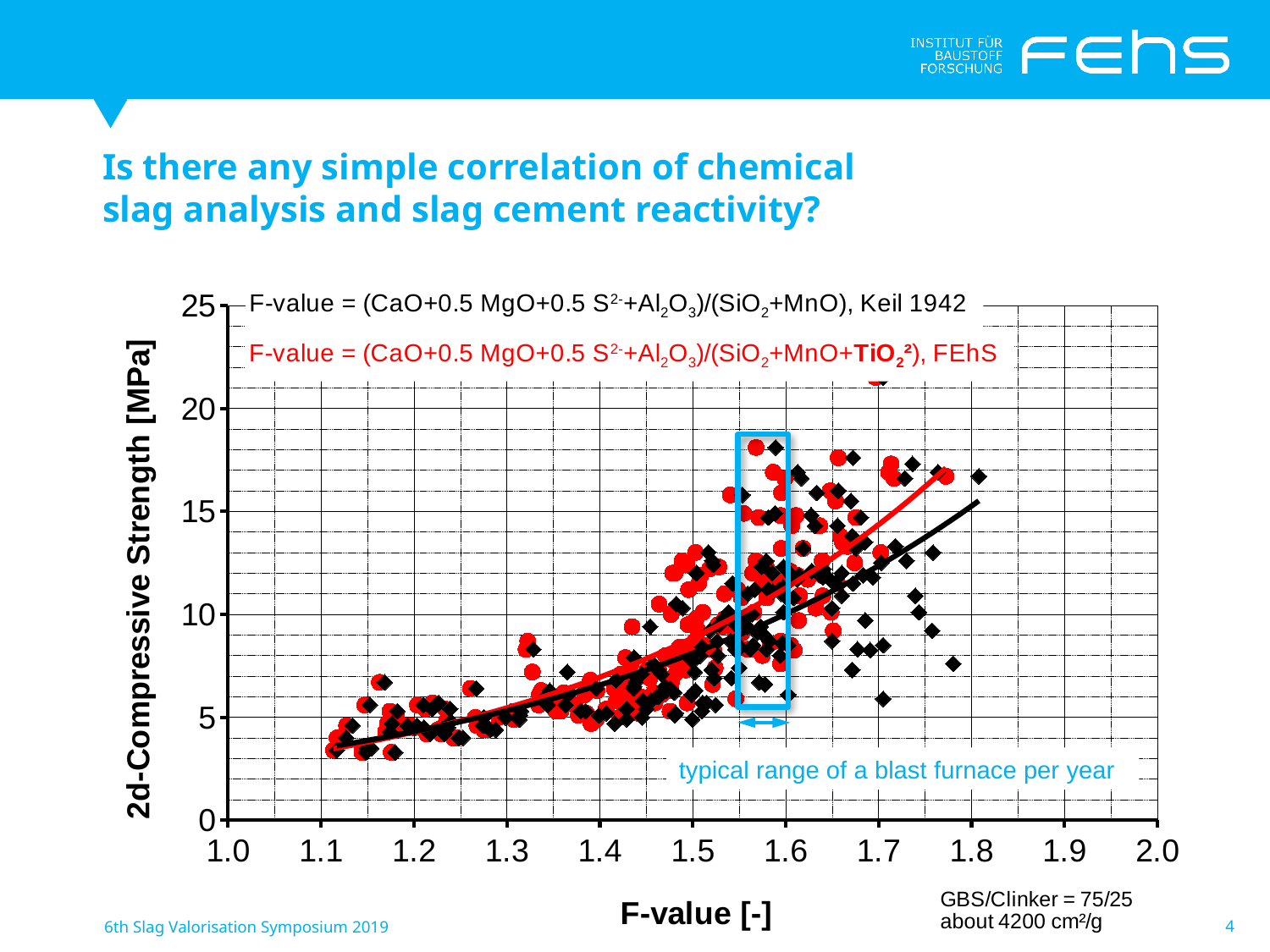
What is the label of the x axis? F-value [-] How many labelled tick values are shown on the x axis? 11 Do the plotted compressive strength values generally rise or fall as the F-value increases along the x axis? rise What kind of chart is shown on the slide? scatter plot How many data series (F-value definitions) does the legend list? 2 Are the lowest plotted 2d-compressive strength values greater or less than 5 MPa? less Which colour represents the FEhS F-value definition that includes TiO2? red At the right end of the fitted curves, which trend line reaches a higher compressive strength, the red (FEhS) or the black (Keil 1942)? red (FEhS) How many labelled tick values are shown on the y axis? 6 Are the highest plotted 2d-compressive strength values greater or less than 15 MPa? greater